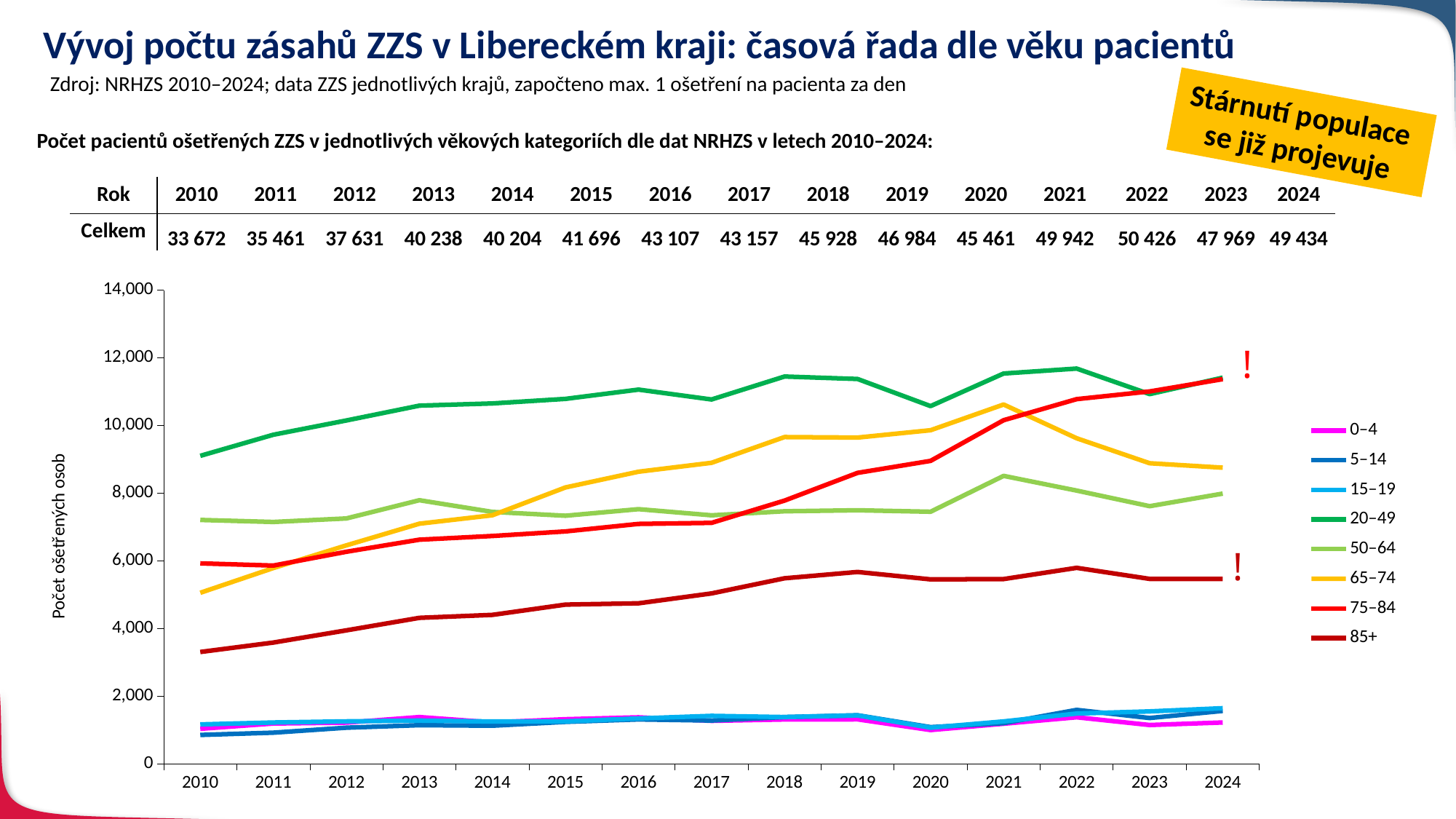
Which age group has the lowest value in 2010? 5–14 Is the value for the 75–84 group in 2024 greater or less than 10,000? greater In 2015, which is larger: the value for the 65–74 group or the 75–84 group? 65–74 What is the title of the chart's vertical axis? Počet ošetřených osob Which age group has the highest value in 2010? 20–49 Which age group has the lowest value in 2024? 0–4 How many years are plotted along the x axis of the chart? 15 Is the value for the 85+ group in 2010 greater or less than 4,000? less What kind of chart is shown on the slide? line chart How many series does the chart legend list? 8 Is the value for the 65–74 group in 2021 greater or less than 10,000? greater Does the value for the 75–84 group generally rise or fall from 2010 to 2024? rise